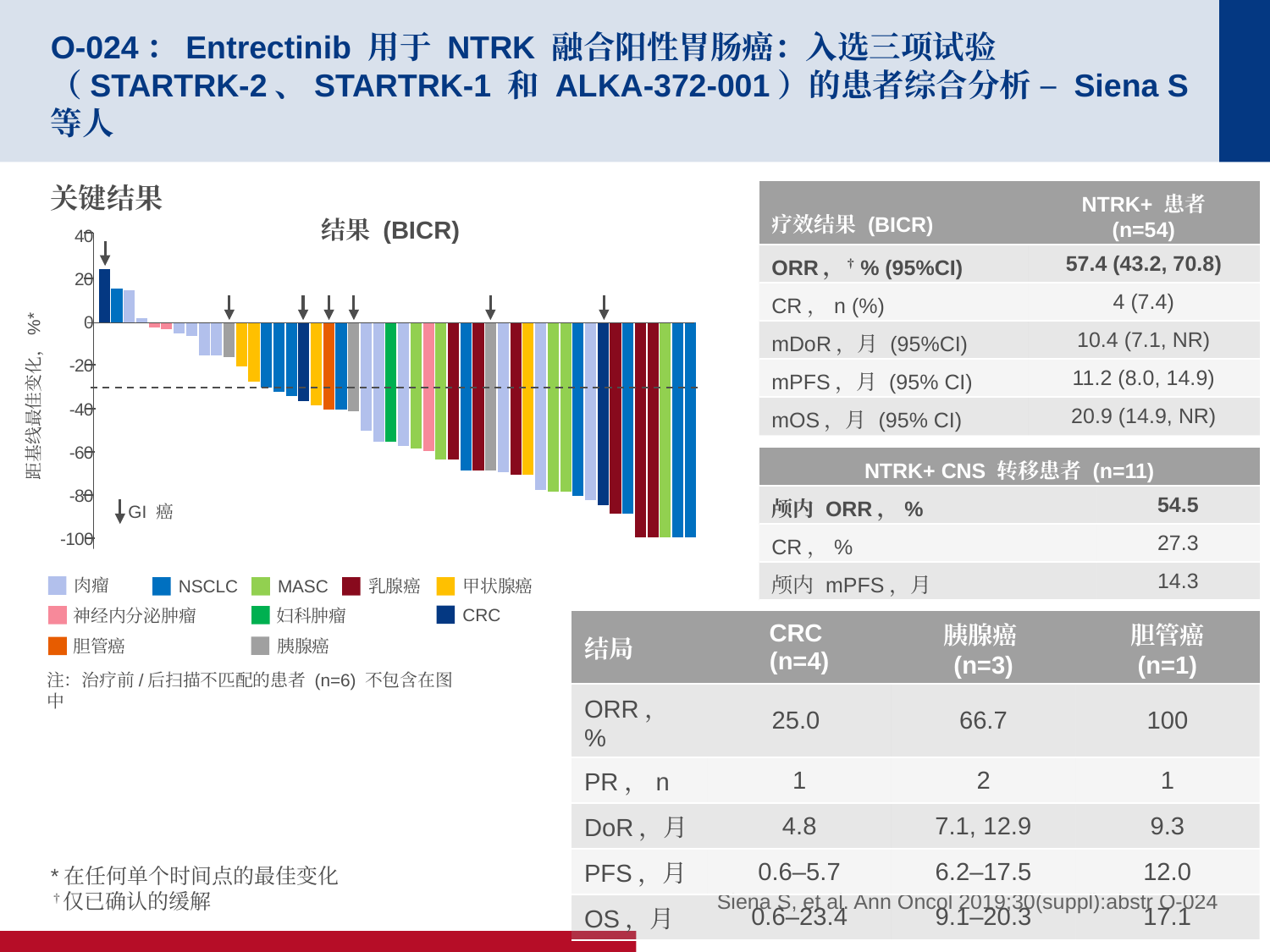
In the 结果 (BICR) chart, is the value of the rightmost bar greater or less than -80? less In the 结果 (BICR) chart, is the value of the rightmost bar greater or less than -60? less In the 结果 (BICR) chart, do the bar values rise or fall from left to right along the x axis? fall How many tumour types does the legend of the 结果 (BICR) chart list? 10 What is the highest value shown on the y axis of the 结果 (BICR) chart? 40 In the 结果 (BICR) chart, is the value of the tallest positive bar (the leftmost bar) greater or less than 20? greater At what y-axis value is the horizontal dashed line drawn in the 结果 (BICR) chart? -30 What is the label of the y axis of the 结果 (BICR) chart? 距基线最佳变化, %* What is the lowest value shown on the y axis of the 结果 (BICR) chart? -100 What kind of chart is shown under the title 结果 (BICR)? bar chart